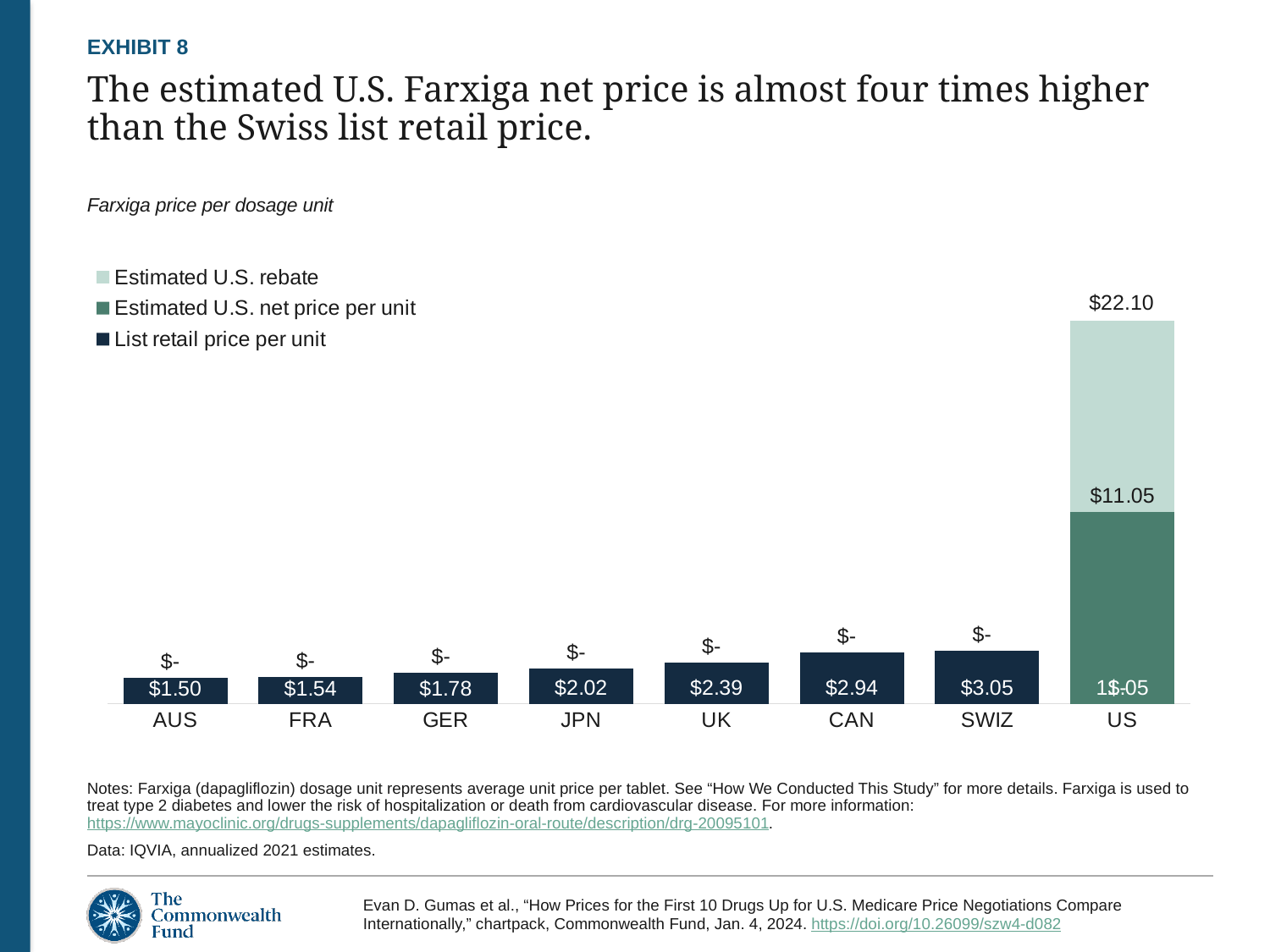
What is the list retail price per unit for AUS? $1.50 What is the difference between the list retail price per unit for CAN and for UK? $0.55 Which has a higher list retail price per unit, GER or FRA? GER Do the list retail prices per unit rise or fall from AUS to SWIZ along the x axis? Rise What is the list retail price per unit for JPN? $2.02 What is the estimated U.S. net price per unit for the US? $11.05 Among AUS, FRA, GER, JPN, UK, CAN and SWIZ, which country has the highest list retail price per unit? SWIZ What is the list retail price per unit for SWIZ? $3.05 What kind of chart is shown on the slide? Stacked bar chart How many countries are shown on the x axis of the chart? 8 How many series does the chart legend list? 3 Among AUS, FRA, GER, JPN, UK, CAN and SWIZ, which country has the lowest list retail price per unit? AUS